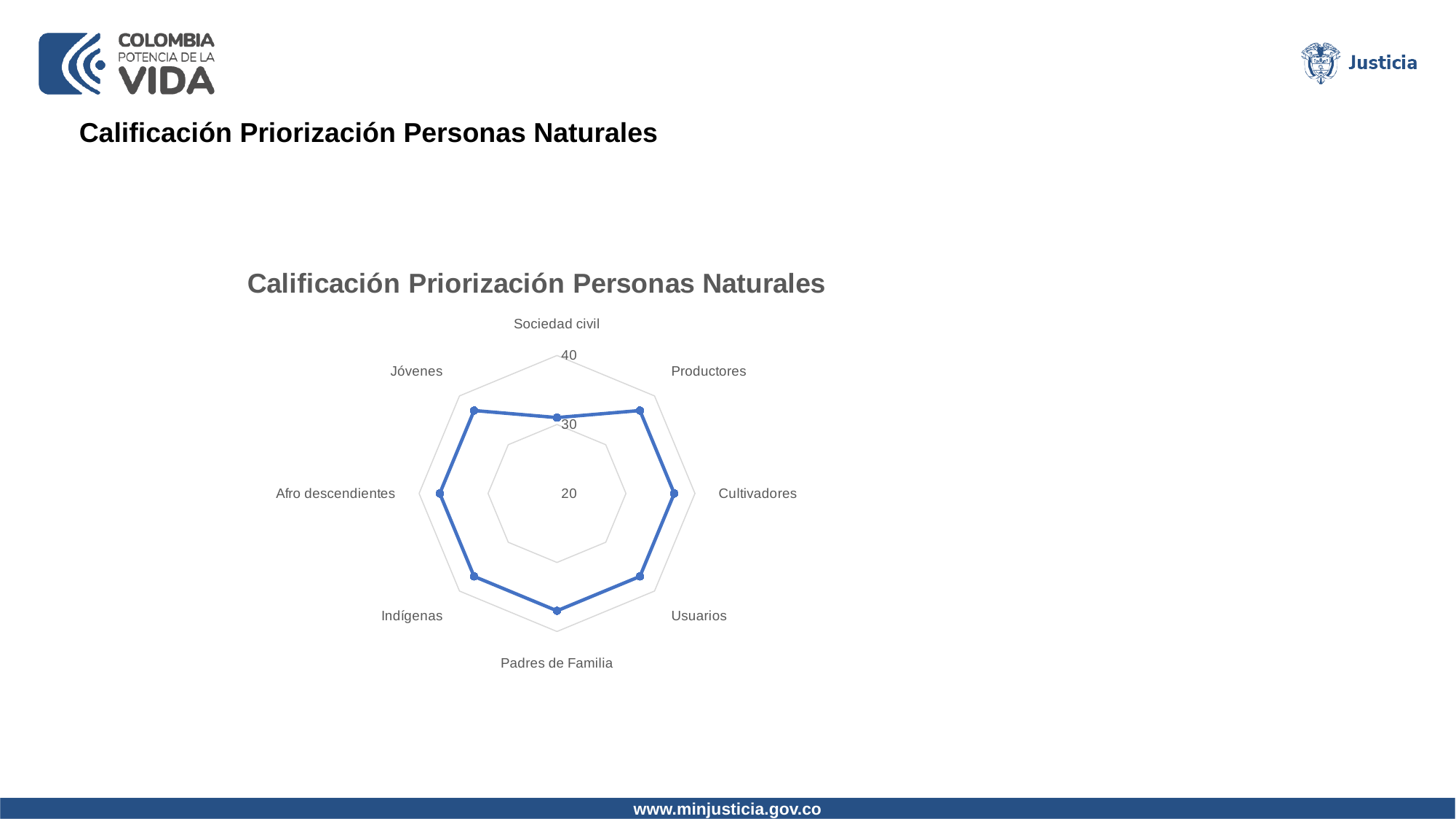
How many categories are plotted on the radar chart? 8 Is the value for Cultivadores greater or less than 30? greater Which is larger, the value for Productores or the value for Sociedad civil? Productores Is the value for Jóvenes greater or less than 40? less Is the value for Padres de Familia greater or less than 30? greater Which category has the lowest value on the chart? Sociedad civil What is the title of the chart? Calificación Priorización Personas Naturales What is the highest value shown on the chart's axis scale? 40 What kind of chart is shown on the slide? radar chart